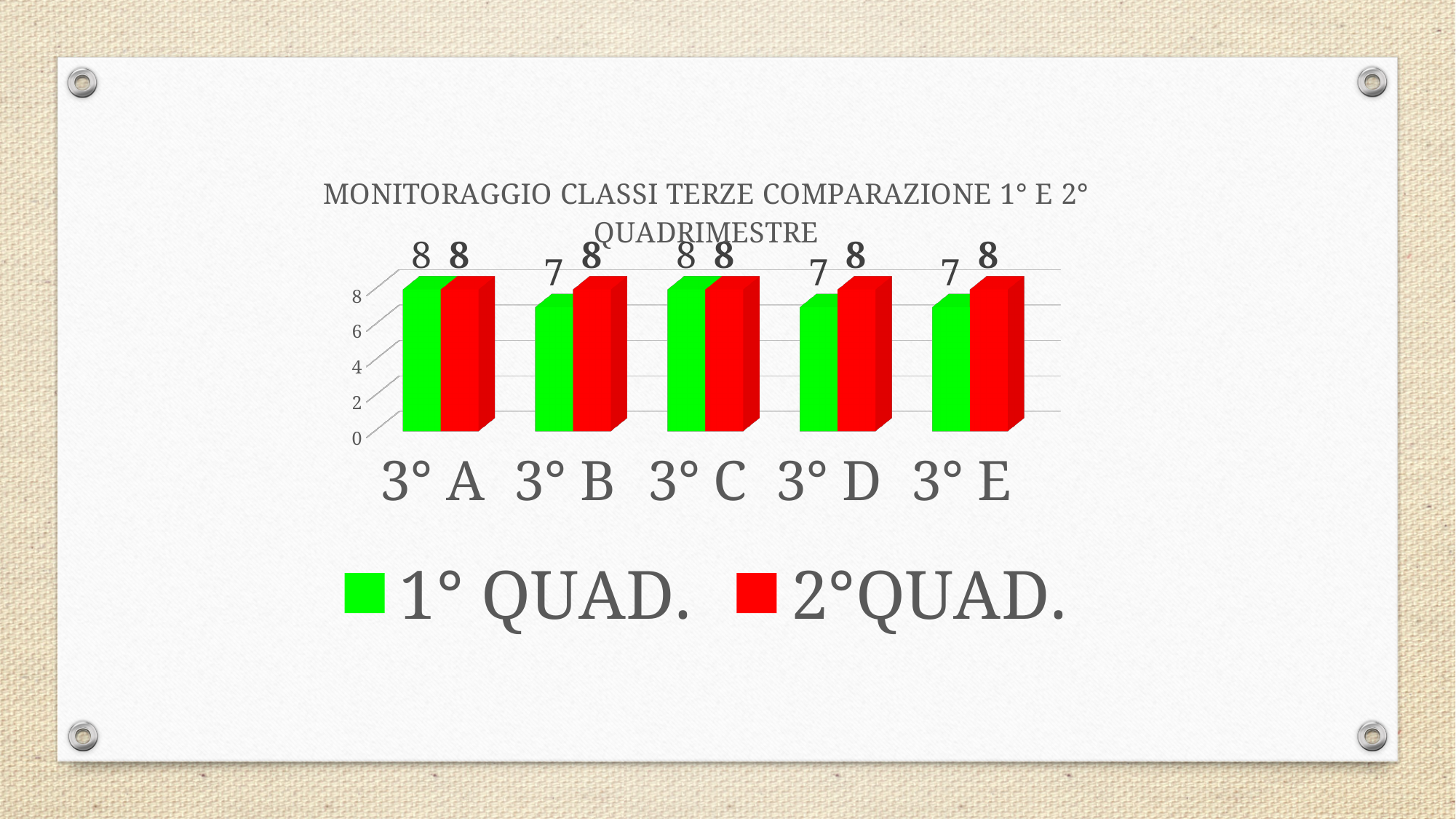
How many classes are shown on the x axis? 5 What colour represents the 2°QUAD. series? Red What is the value for 3° A in the 1° QUAD. series? 8 Which is larger for 3° E: the 1° QUAD. value or the 2°QUAD. value? 2°QUAD. What is the value for 3° D in the 2°QUAD. series? 8 How many series does the legend list? 2 What is the value for 3° E in the 1° QUAD. series? 7 What is the value for 3° B in the 1° QUAD. series? 7 What kind of chart is shown on the slide? Bar chart What is the difference between the 2°QUAD. and 1° QUAD. values for 3° D? 1 What is the title of the chart? MONITORAGGIO CLASSI TERZE COMPARAZIONE 1° E 2° QUADRIMESTRE Which classes have a 1° QUAD. value of 7? 3° B, 3° D, 3° E